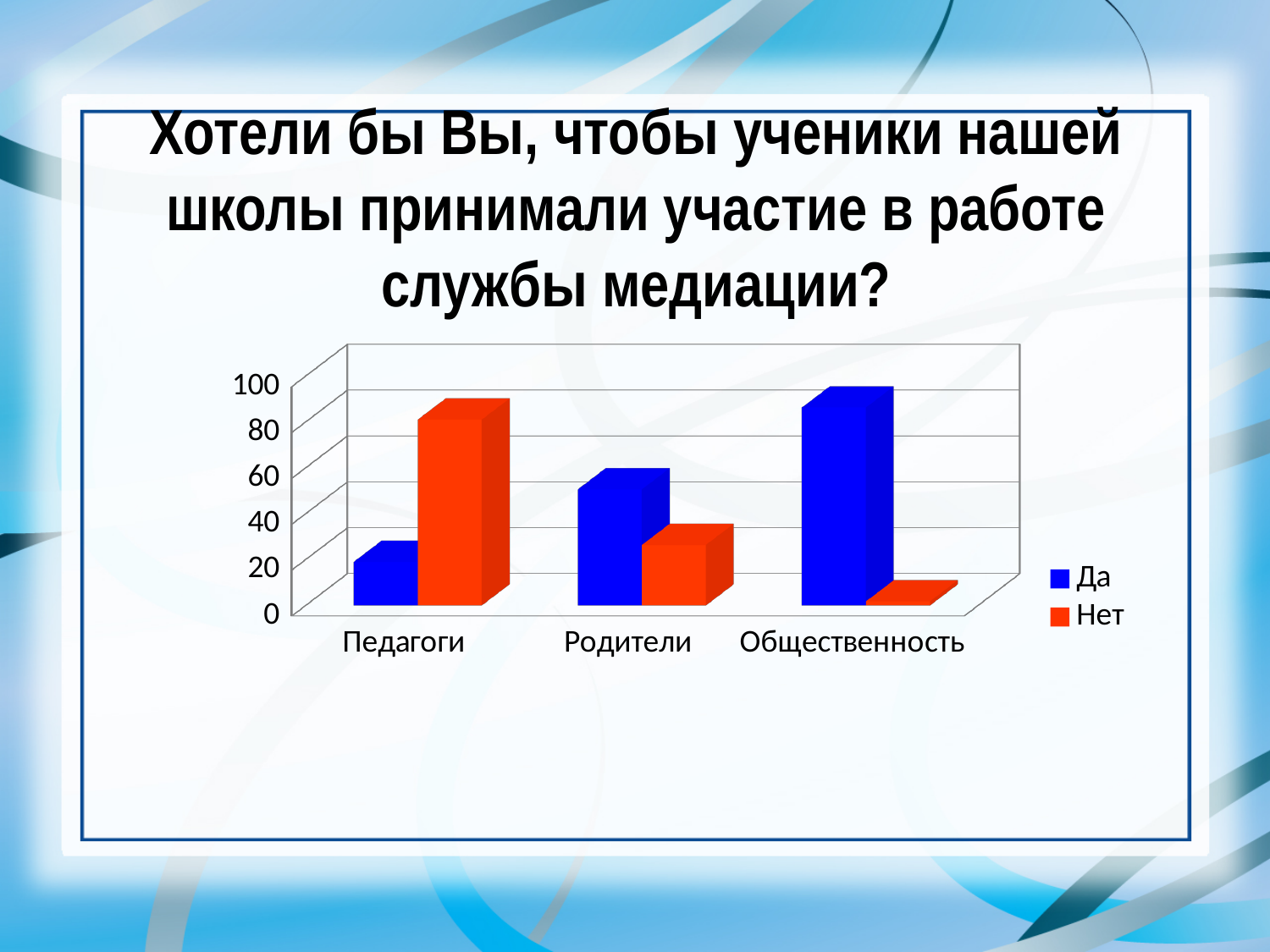
Is the value for Нет in the Педагоги category greater or less than 60? greater How many categories are shown on the x axis of the chart? 3 Which category has the lowest value for the series Нет? Общественность Which category has the highest value for the series Нет? Педагоги Which category has the highest value for the series Да? Общественность Which colour represents the series Нет in the legend? red Is the value for Да in the Общественность category greater or less than 80? greater How many series does the legend list? 2 For Педагоги, which is larger: Да or Нет? Нет Which category has the lowest value for the series Да? Педагоги For Родители, which is larger: Да or Нет? Да What kind of chart is shown on the slide? bar chart